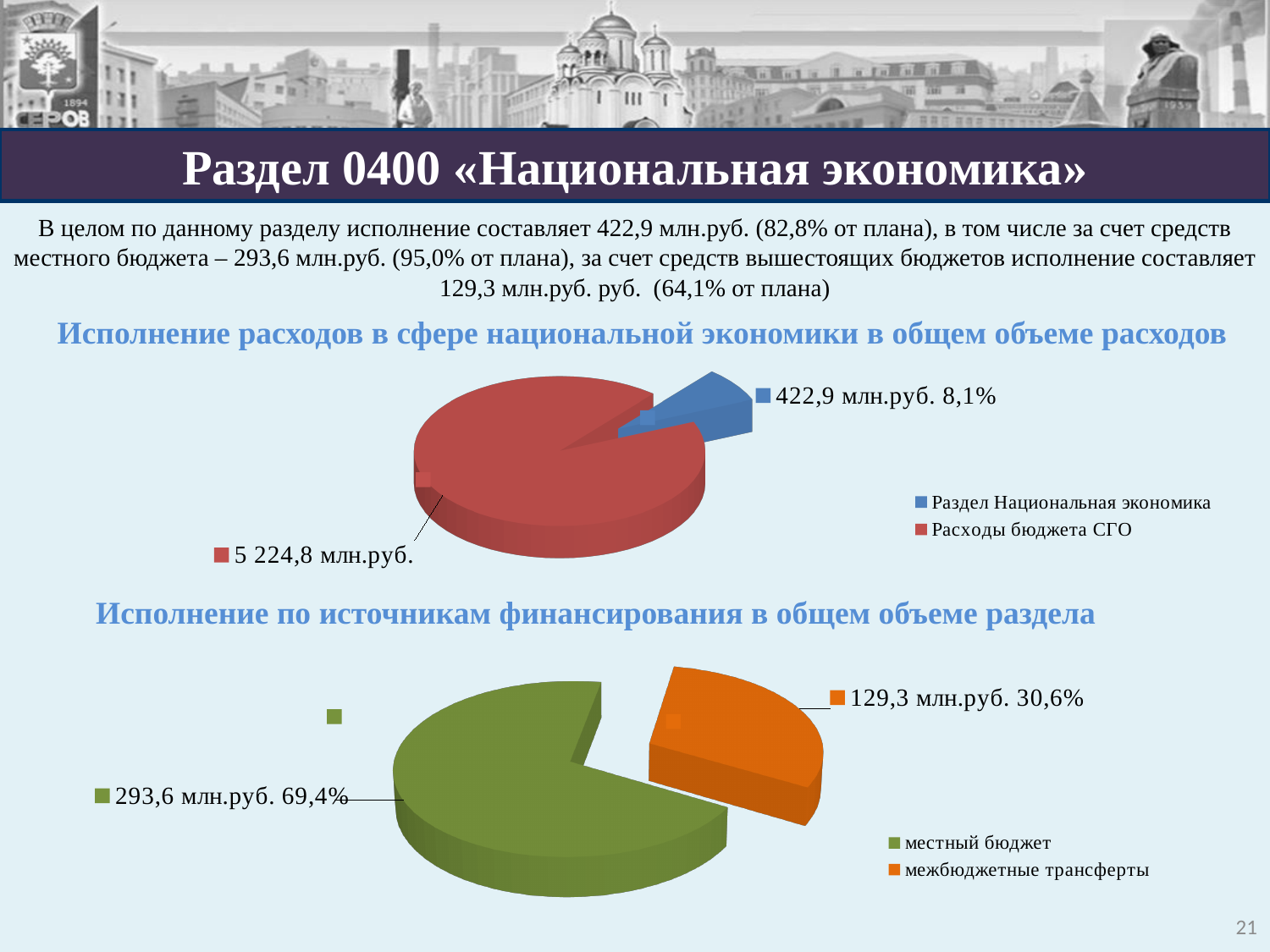
In the bottom pie chart, what value is shown for 'местный бюджет'? 293,6 млн.руб. In the bottom pie chart, what share of the pie does 'межбюджетные трансферты' represent? 30,6% What type of chart is the top chart on the slide? pie chart In the bottom pie chart, what colour is the slice for 'межбюджетные трансферты'? orange In the top pie chart, what share of the pie does 'Раздел Национальная экономика' represent? 8,1% In the bottom pie chart, what is the difference between the values for 'местный бюджет' and 'межбюджетные трансферты'? 164,3 млн.руб. In the top pie chart, what value is shown for 'Расходы бюджета СГО'? 5 224,8 млн.руб. In the bottom pie chart, which slice is the largest? местный бюджет In the top pie chart, what value is shown for the slice 'Раздел Национальная экономика'? 422,9 млн.руб. How many entries does the legend of the top pie chart list? 2 How many slices does the bottom pie chart have? 2 In the top pie chart, which slice is larger: 'Раздел Национальная экономика' or 'Расходы бюджета СГО'? Расходы бюджета СГО